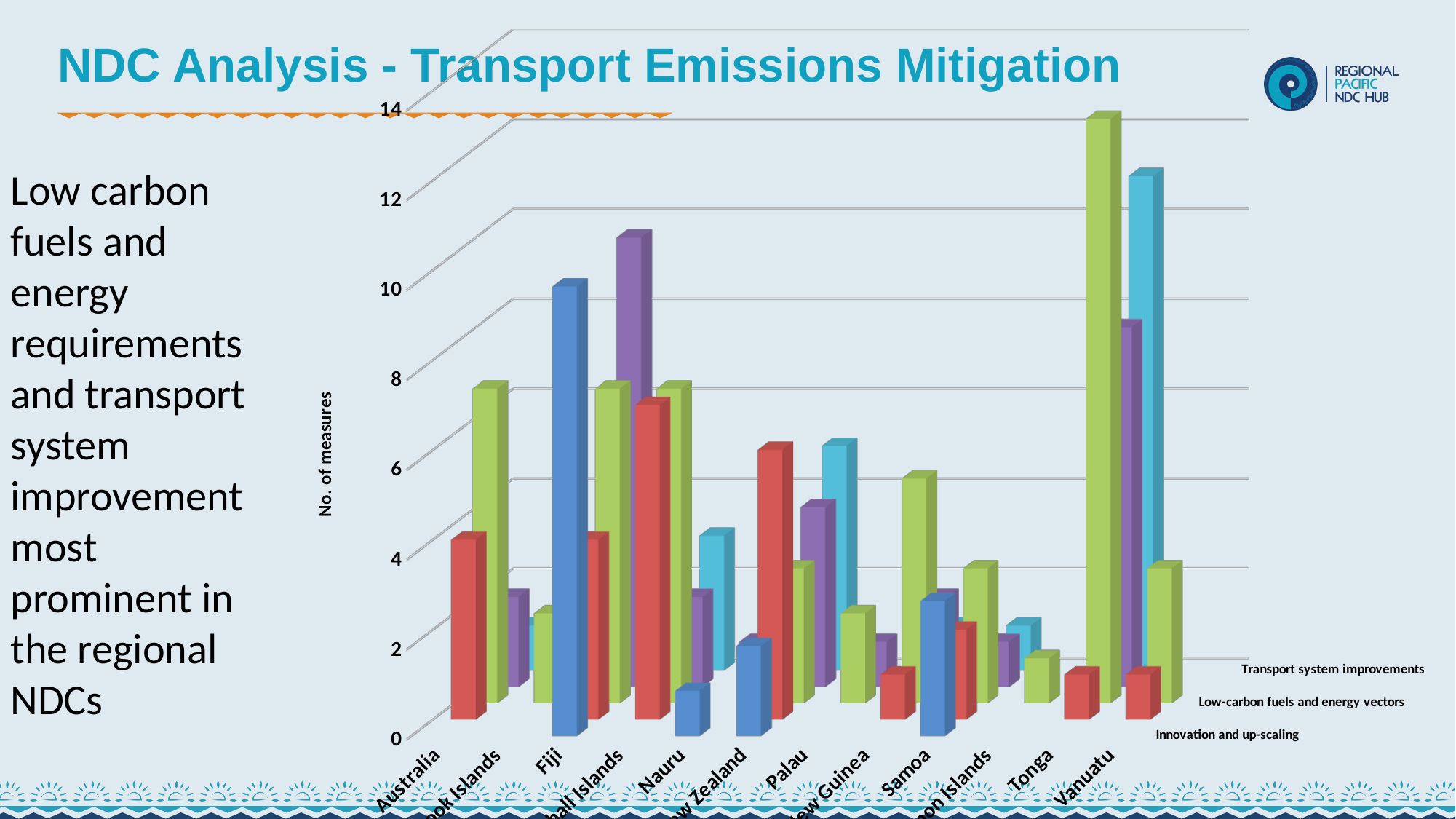
What is the maximum value shown on the vertical axis of the chart? 14 Is the tallest bar for Fiji greater or less than 8? greater Is the tallest bar for Australia greater or less than 2? greater What is the title of the slide containing the chart? NDC Analysis - Transport Emissions Mitigation How many countries are shown along the x axis of the chart? 12 Which country has a taller tallest bar, Vanuatu or Tonga? Tonga Is the tallest bar for Vanuatu greater or less than 12? less Which country has the tallest bar in the chart? Tonga What is the label on the vertical axis of the chart? No. of measures What kind of chart is shown on the slide? bar chart